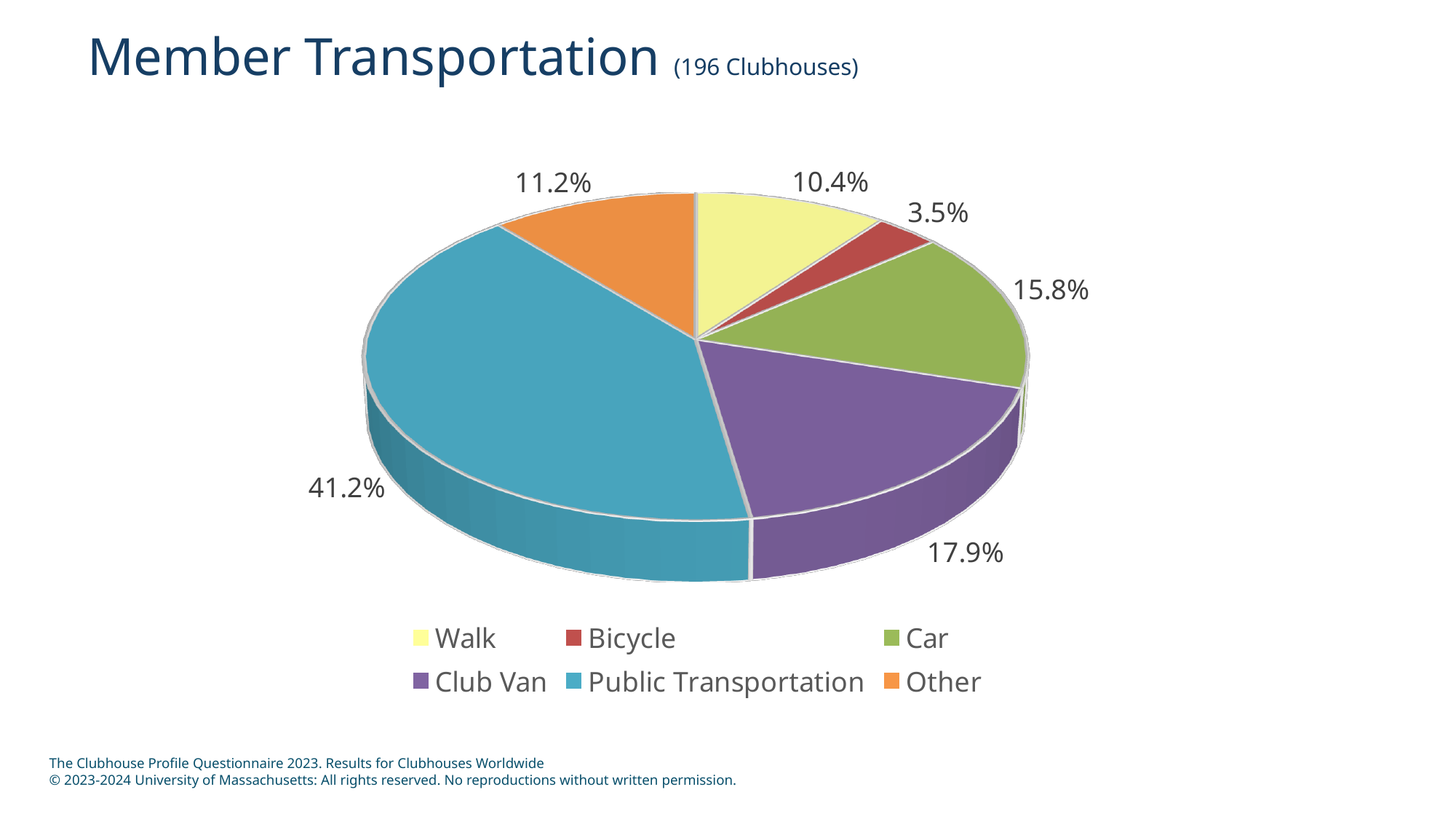
What percentage of the pie is Car? 15.8% What kind of chart is shown on the slide? Pie chart What percentage of the pie is Bicycle? 3.5% How many categories does the pie chart have? 6 What percentage of the pie is Club Van? 17.9% What colour is the Car slice in the pie chart? Green What percentage of the pie is Public Transportation? 41.2% Which category has the smallest share of the pie? Bicycle What percentage of the pie is Walk? 10.4% What is the difference in percentage points between Public Transportation and Club Van? 23.3 Which category has the largest share of the pie? Public Transportation Which is larger, the share for Other or the share for Walk? Other